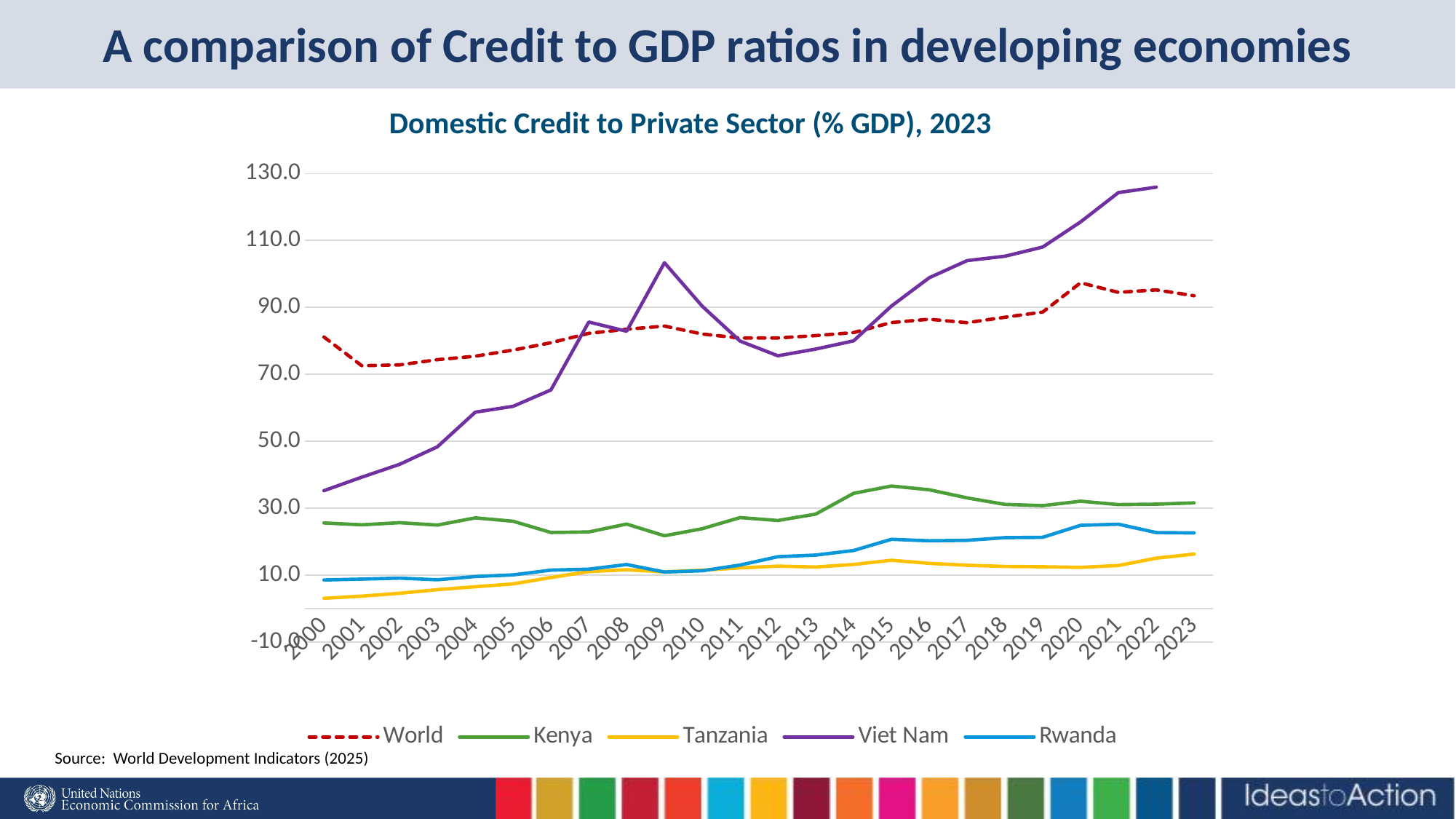
In 2009, which is larger: the value for Viet Nam or the value for World? Viet Nam What kind of chart is shown on the slide? line chart Is the value for Viet Nam in 2022 greater or less than 110? greater How many series does the legend list? 5 In 2012, which is larger: the value for World or the value for Viet Nam? World Is the value for Kenya in 2015 greater or less than 30? greater Which series has the highest value in 2022? Viet Nam Which series is drawn with a dashed line? World How many years are shown along the x axis? 24 Which series has the lowest value in 2000? Tanzania Does the Viet Nam line rise or fall between 2012 and 2022? rise Is the value for Rwanda in 2021 greater or less than 30? less